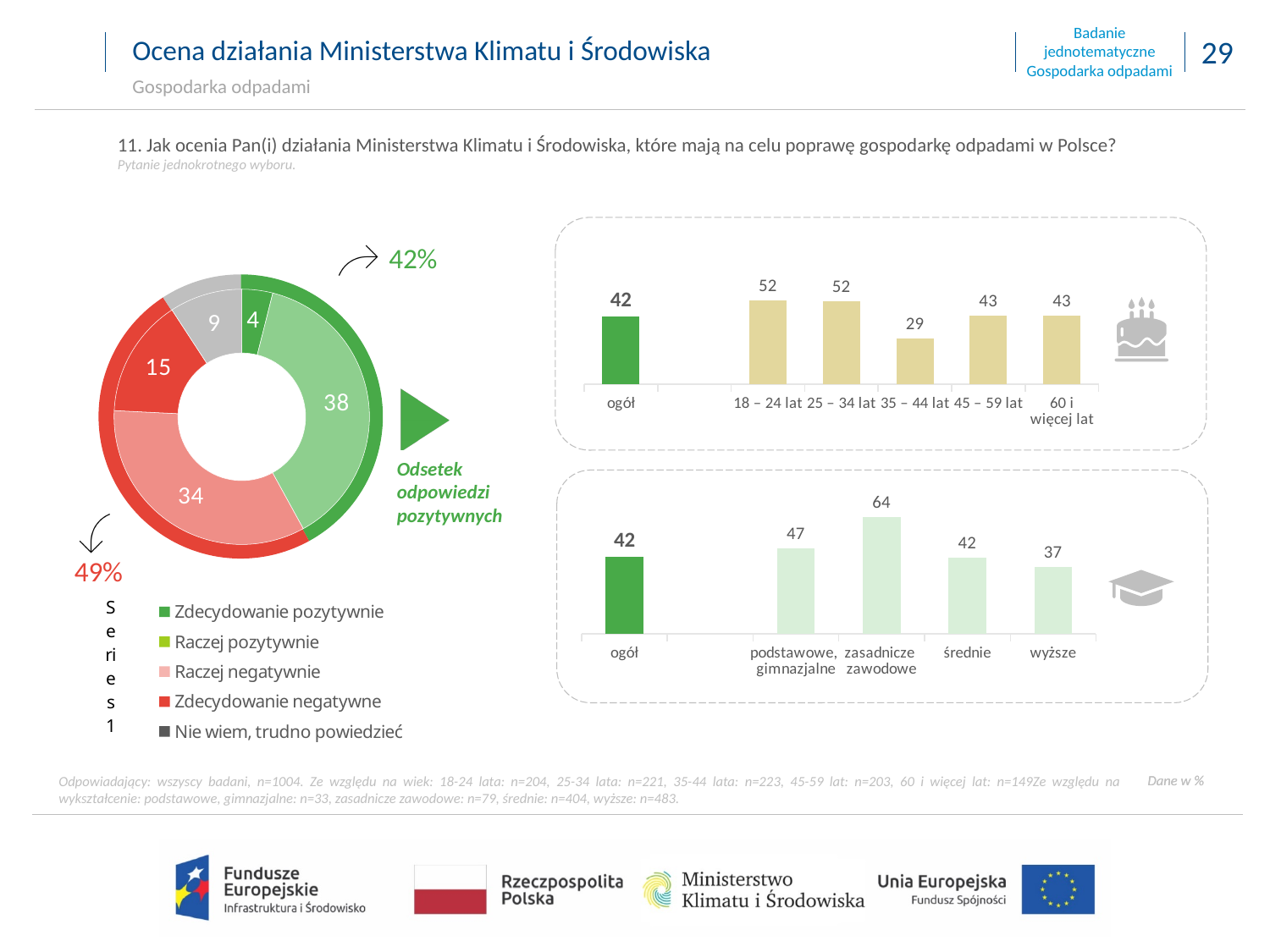
In the bottom-right bar chart by education, which category has the highest value? zasadnicze zawodowe In the donut chart on the left, what is the difference between 'Raczej negatywnie' and 'Zdecydowanie negatywnie'? 19 In the top-right bar chart by age, which age group has the lowest value? 35 – 44 lat In the bottom-right bar chart by education, what is the difference between 'zasadnicze zawodowe' and 'ogół'? 22 In the donut chart on the left, what is the value for 'Raczej pozytywnie'? 38 In the top-right bar chart by age, how many bars are shown? 6 In the top-right bar chart by age, what is the value for '35 – 44 lat'? 29 In the bottom-right bar chart by education, what is the value for 'wyższe'? 37 In the donut chart on the left, which category has the smallest value? Zdecydowanie pozytywnie In the donut chart on the left, what is the value for 'Zdecydowanie negatywnie'? 15 What type of chart is the bottom-right chart by education? bar chart How many entries does the legend of the donut chart on the left list? 5